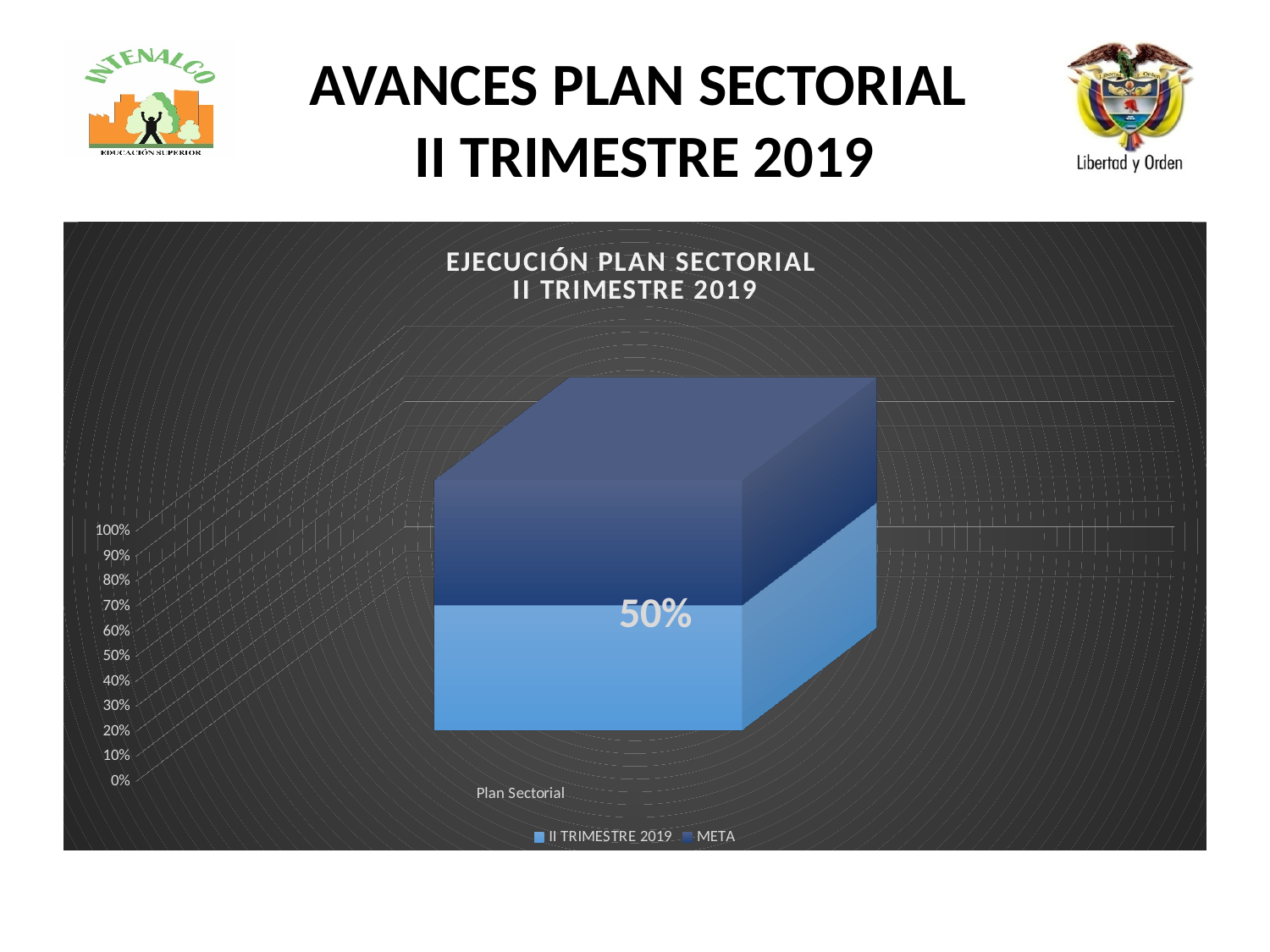
Is the value of the II TRIMESTRE 2019 series for Plan Sectorial greater or less than 40%? greater What is the title of the chart? EJECUCIÓN PLAN SECTORIAL II TRIMESTRE 2019 Is the value of the II TRIMESTRE 2019 series for Plan Sectorial greater or less than 60%? less What is the name of the category shown on the x axis? Plan Sectorial How many categories are shown on the x axis? 1 What kind of chart is shown on the slide? bar chart What is the value of the II TRIMESTRE 2019 series for Plan Sectorial? 50% How many series does the legend list? 2